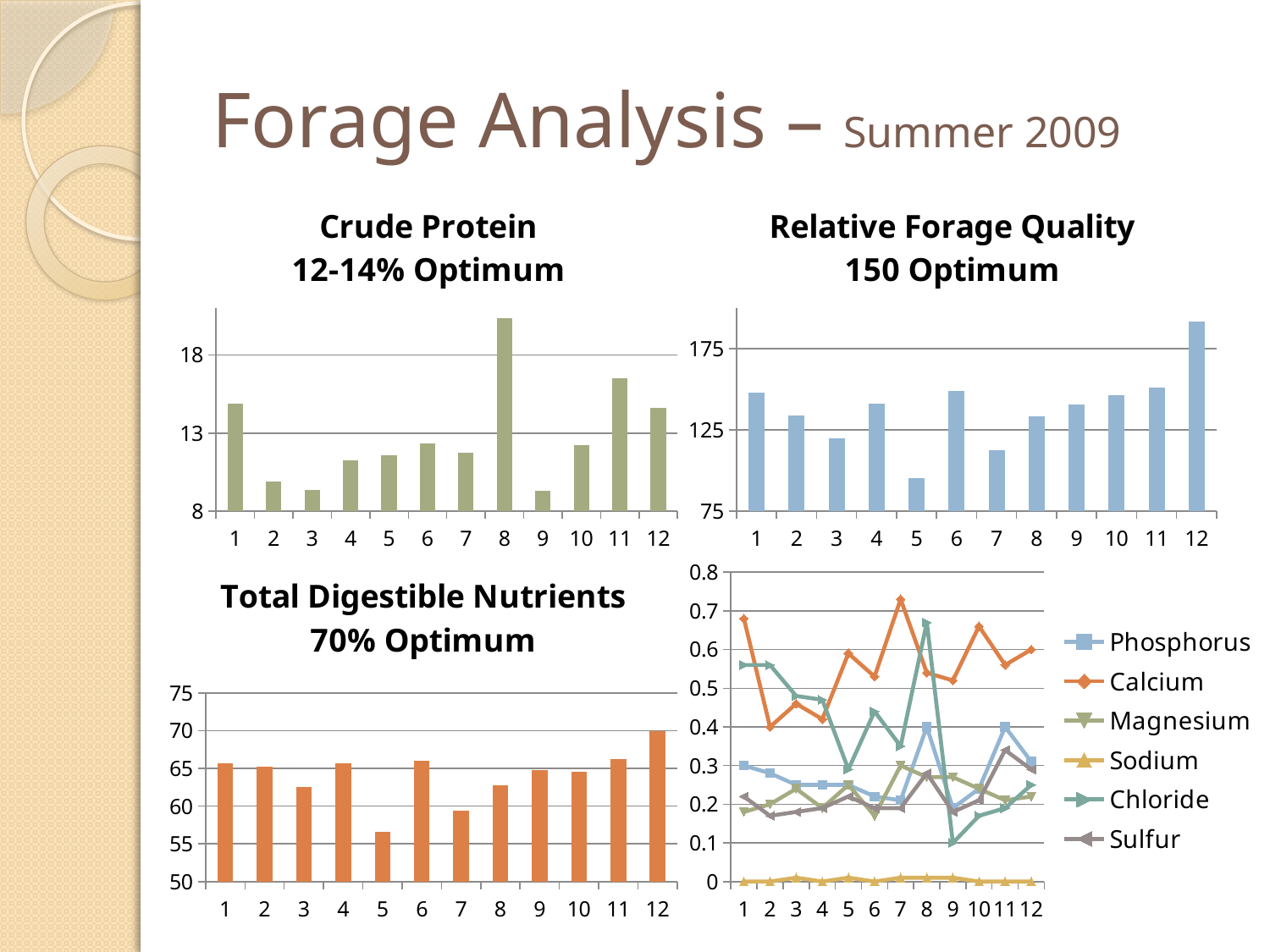
How many series does the legend of the bottom-right line chart list? 6 In the Total Digestible Nutrients chart, which sample number has the lowest value? 5 In the Relative Forage Quality chart, is the value for sample 5 greater or less than 125? less In the Crude Protein chart, is the value for sample 8 greater or less than 18? greater In the Total Digestible Nutrients chart, which sample number has the highest value? 12 In the Relative Forage Quality chart, which sample number has the lowest value? 5 In the Relative Forage Quality chart, which sample number has the highest value? 12 In the Crude Protein chart, which sample number has the highest value? 8 In the Total Digestible Nutrients chart, is the value for sample 7 greater or less than 60? less What kind of chart is the Crude Protein chart? bar chart In the bottom-right line chart, which series has the lowest values across all samples? Sodium